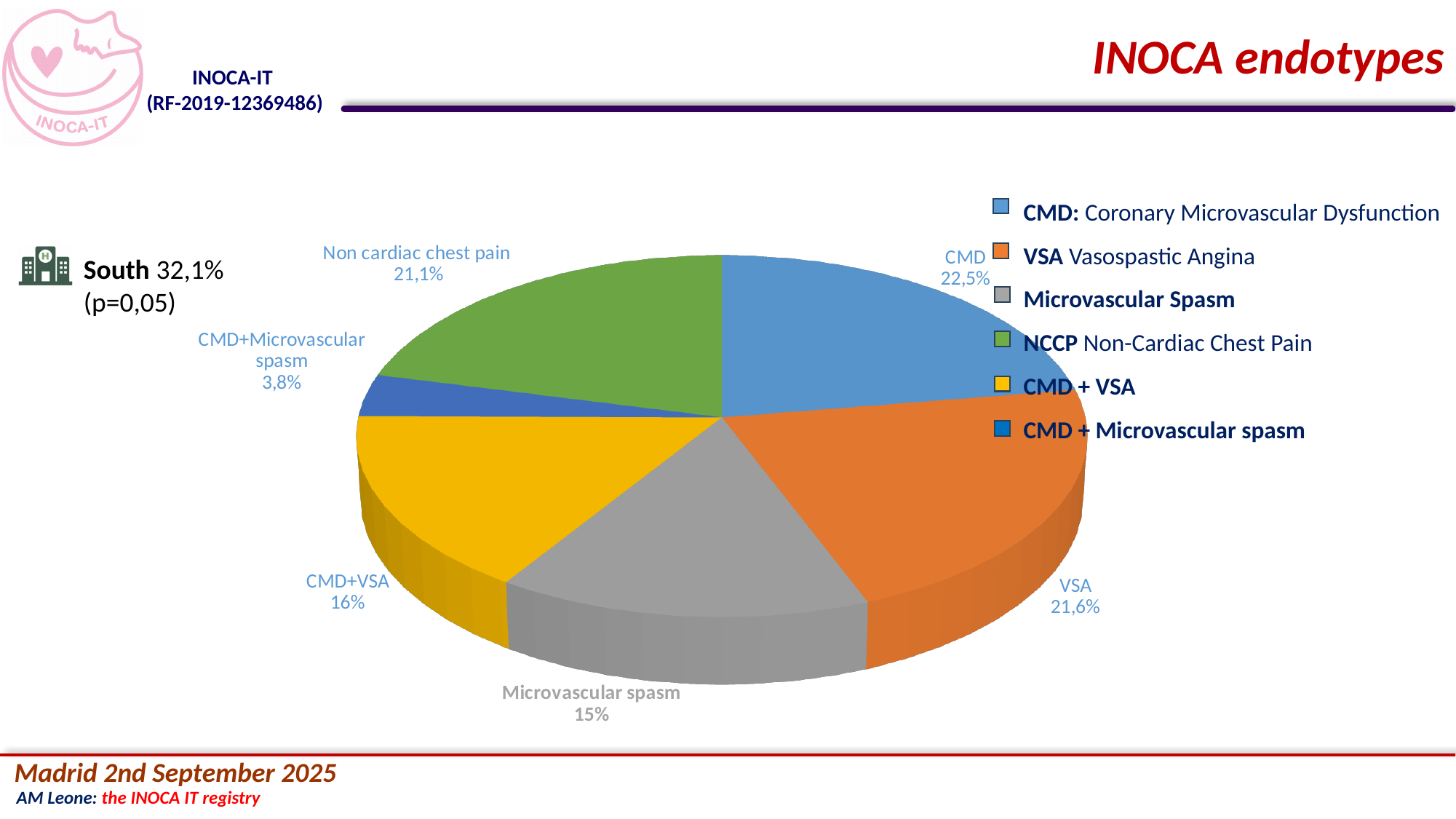
What share of the pie does CMD+VSA represent? 16% How many slices does the pie chart have? 6 Which endotype has the smallest slice of the pie? CMD+Microvascular spasm Which slice is larger, CMD+VSA or Microvascular spasm? CMD+VSA What does the legend say the abbreviation NCCP stands for? Non-Cardiac Chest Pain What share of the pie does CMD represent? 22,5% What share of the pie does Microvascular spasm represent? 15% Which endotype has the largest slice of the pie? CMD What is the difference in percentage points between the Non cardiac chest pain slice and the Microvascular spasm slice? 6,1 What share of the pie does CMD+Microvascular spasm represent? 3,8% What kind of chart is shown on the slide? Pie chart What share of the pie does VSA represent? 21,6%